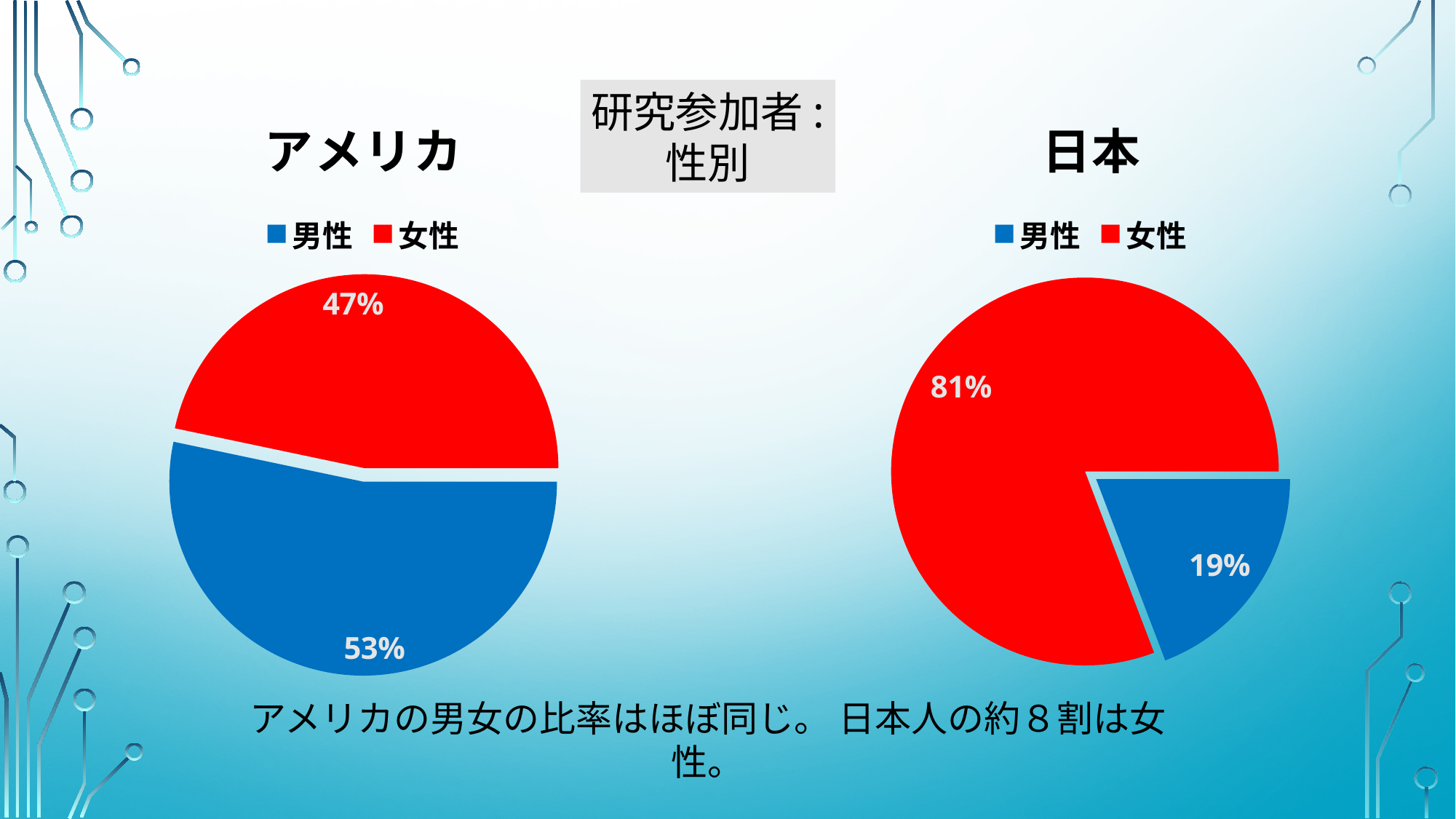
In the 日本 pie chart, what colour is the 男性 slice? Blue In the 日本 pie chart, which category has the largest slice? 女性 In the 日本 pie chart, what is the difference between the 女性 and 男性 values? 62% In the 日本 pie chart, what is the value for 男性? 19% In the アメリカ pie chart, what is the difference between the 男性 and 女性 values? 6% In the アメリカ pie chart, which category has the smallest slice? 女性 In the 日本 pie chart, what is the value for 女性? 81% In the アメリカ pie chart, what is the value for 女性? 47% What kind of chart is the アメリカ chart? Pie chart How many slices does the 日本 pie chart have? 2 In the アメリカ pie chart, which is larger, 男性 or 女性? 男性 In the アメリカ pie chart, what is the value for 男性? 53%